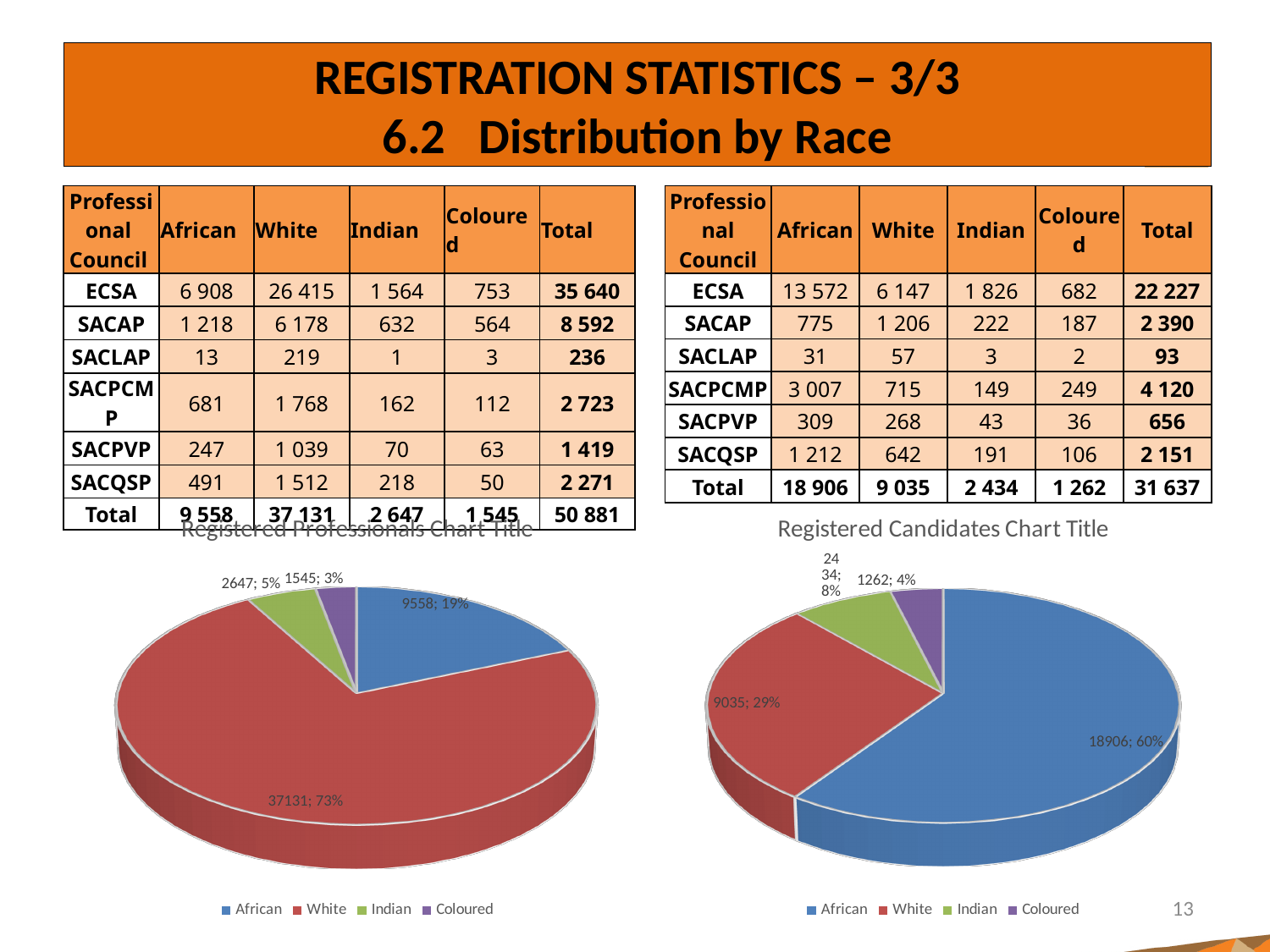
In the Registered Candidates chart, which category has the largest slice? African In the Registered Candidates chart, what is the difference between the African value and the White value? 9871 In the Registered Professionals chart, which category has the largest slice? White In the Registered Professionals chart, what is the difference between the White value and the African value? 27573 How many series does the legend of the Registered Professionals chart list? 4 In the Registered Professionals chart, which category has the smallest slice? Coloured In the Registered Professionals chart, what value is shown for White? 37131 In the Registered Candidates chart, what percentage share does the White slice have? 29% In the Registered Professionals chart, what percentage share does the African slice have? 19% In the Registered Candidates chart, which is larger, the Indian value or the Coloured value? Indian What kind of chart is the Registered Candidates chart? Pie chart In the Registered Candidates chart, what value is shown for African? 18906